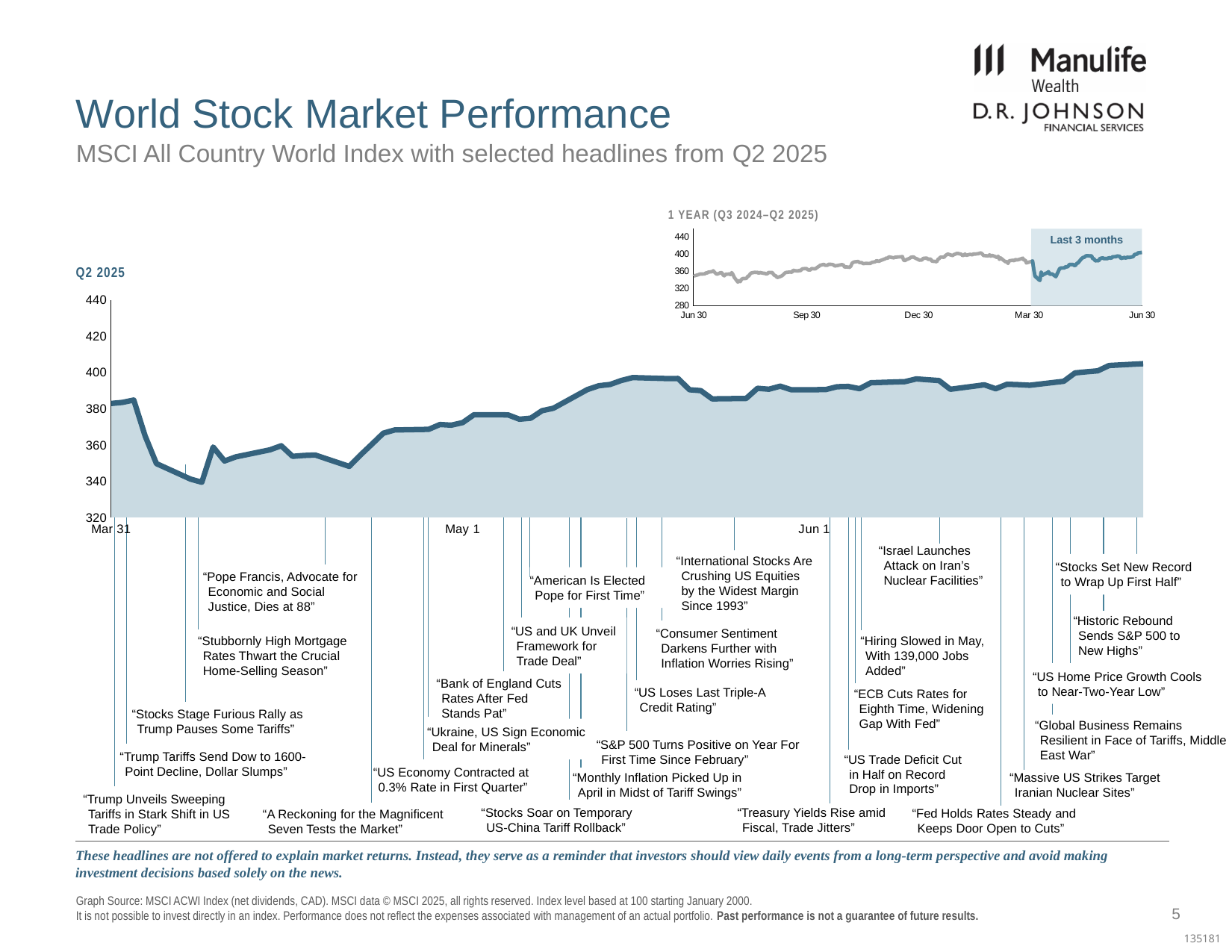
What label is shown on the shaded region of the inset '1 YEAR (Q3 2024–Q2 2025)' chart? Last 3 months On the main Q2 2025 chart, is the lowest point of the index in early April greater or less than 360? less How many date labels are shown on the x axis of the inset '1 YEAR (Q3 2024–Q2 2025)' chart? 5 What kind of chart is the main Q2 2025 chart on the slide? Area chart On the main Q2 2025 chart, is the index value at the end of June (right edge) greater or less than 400? greater What kind of chart is the small inset chart titled '1 YEAR (Q3 2024–Q2 2025)'? Line chart On the main Q2 2025 chart, is the index value at Jun 1 greater or less than 380? greater On the main Q2 2025 chart, does the index rise or fall between Mar 31 and the low point in early April? fall On the main Q2 2025 chart, does the index overall rise or fall from Mar 31 to the end of June? rise